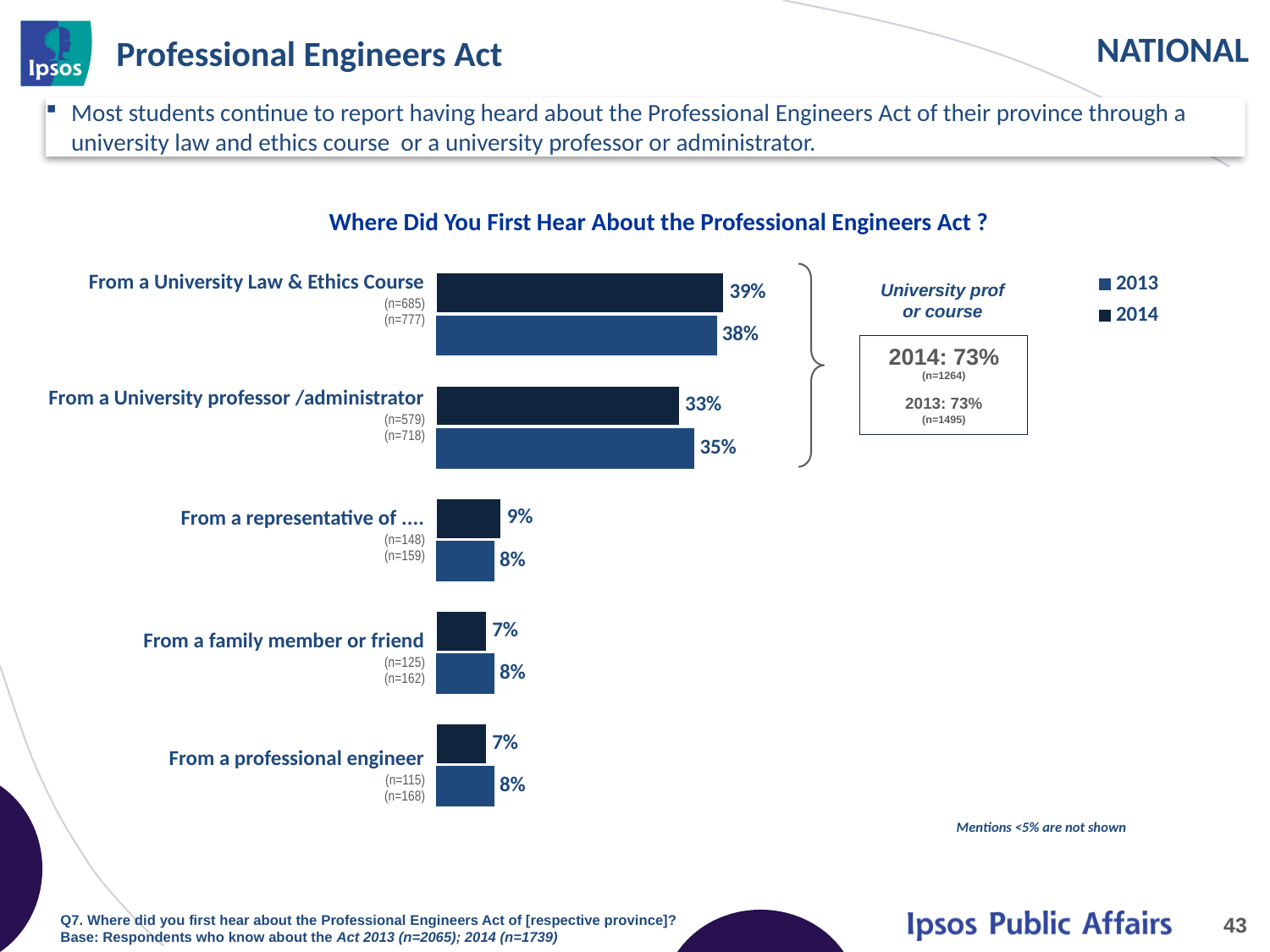
What is the difference between the 2013 and 2014 values for 'From a University professor /administrator'? 2% How many categories are shown in the chart? 5 Which category has the highest 2013 value? From a University Law & Ethics Course What is the title of the chart? Where Did You First Hear About the Professional Engineers Act ? What is the 2014 value for 'From a University professor /administrator'? 33% What is the 2014 value for 'From a family member or friend'? 7% How many series does the legend list? 2 What combined 2014 percentage is shown in the callout box for 'University prof or course'? 73% What type of chart is shown on the slide? bar chart What is the 2013 value for 'From a University Law & Ethics Course'? 38% Which is larger for 'From a University Law & Ethics Course': the 2013 value or the 2014 value? 2014 What is the difference between the 2013 values for 'From a University Law & Ethics Course' and 'From a University professor /administrator'? 3%